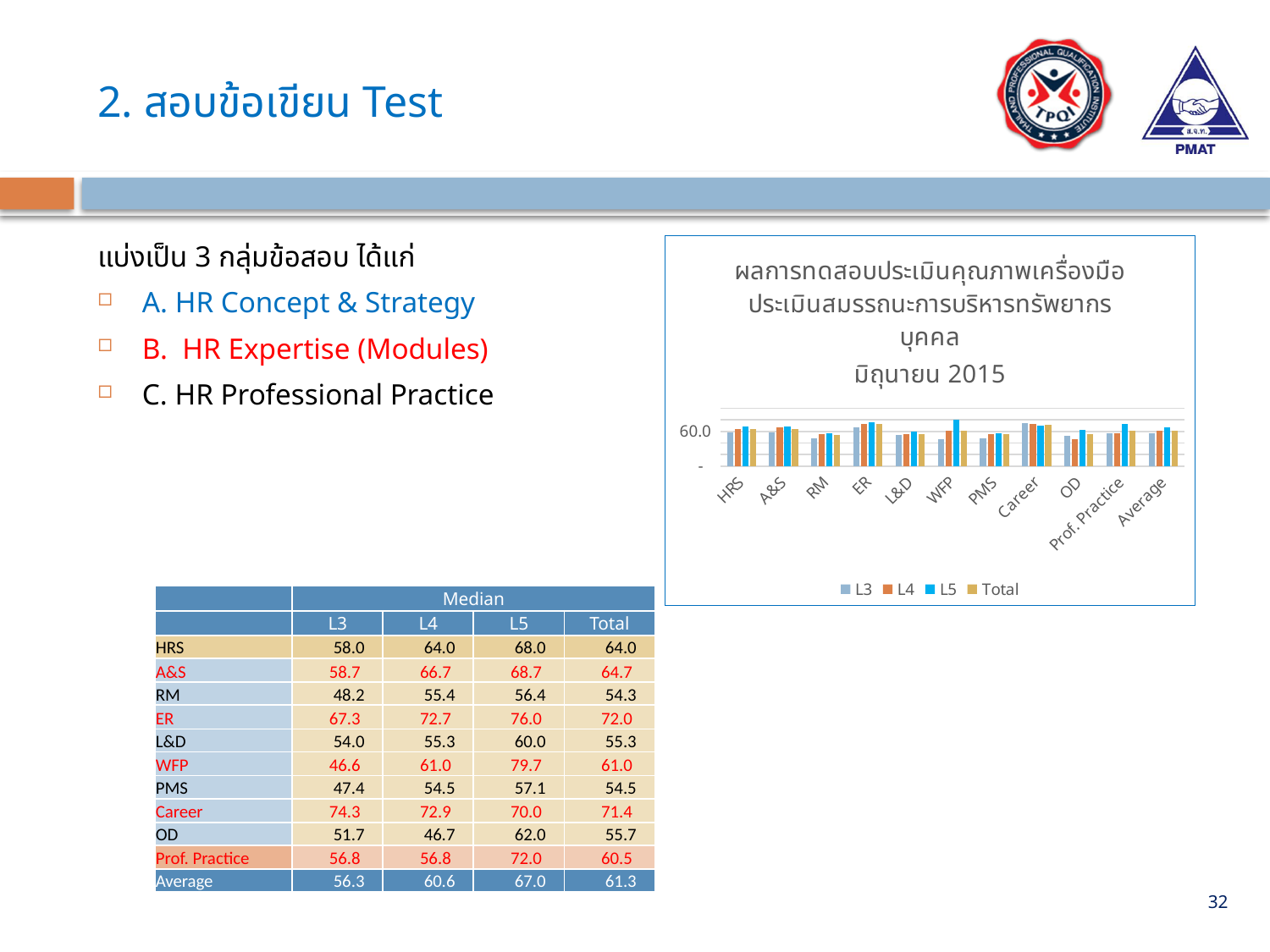
Which series are listed in the chart legend? L3, L4, L5, Total Is the L3 value for RM greater or less than 60.0? less What kind of chart is shown on the slide? bar chart Is the L5 value for WFP greater or less than 60.0? greater How many series does the chart legend list? 4 Which category has the highest L3 bar in the chart? Career Which category has the lowest L4 bar in the chart? OD How many categories are shown along the x axis of the chart? 11 According to the table, what is the Total median for ER? 72.0 Is the L5 value for ER greater or less than 60.0? greater Which category has the highest L5 bar in the chart? WFP According to the table, what is the difference between the L5 and L3 medians for WFP? 33.1